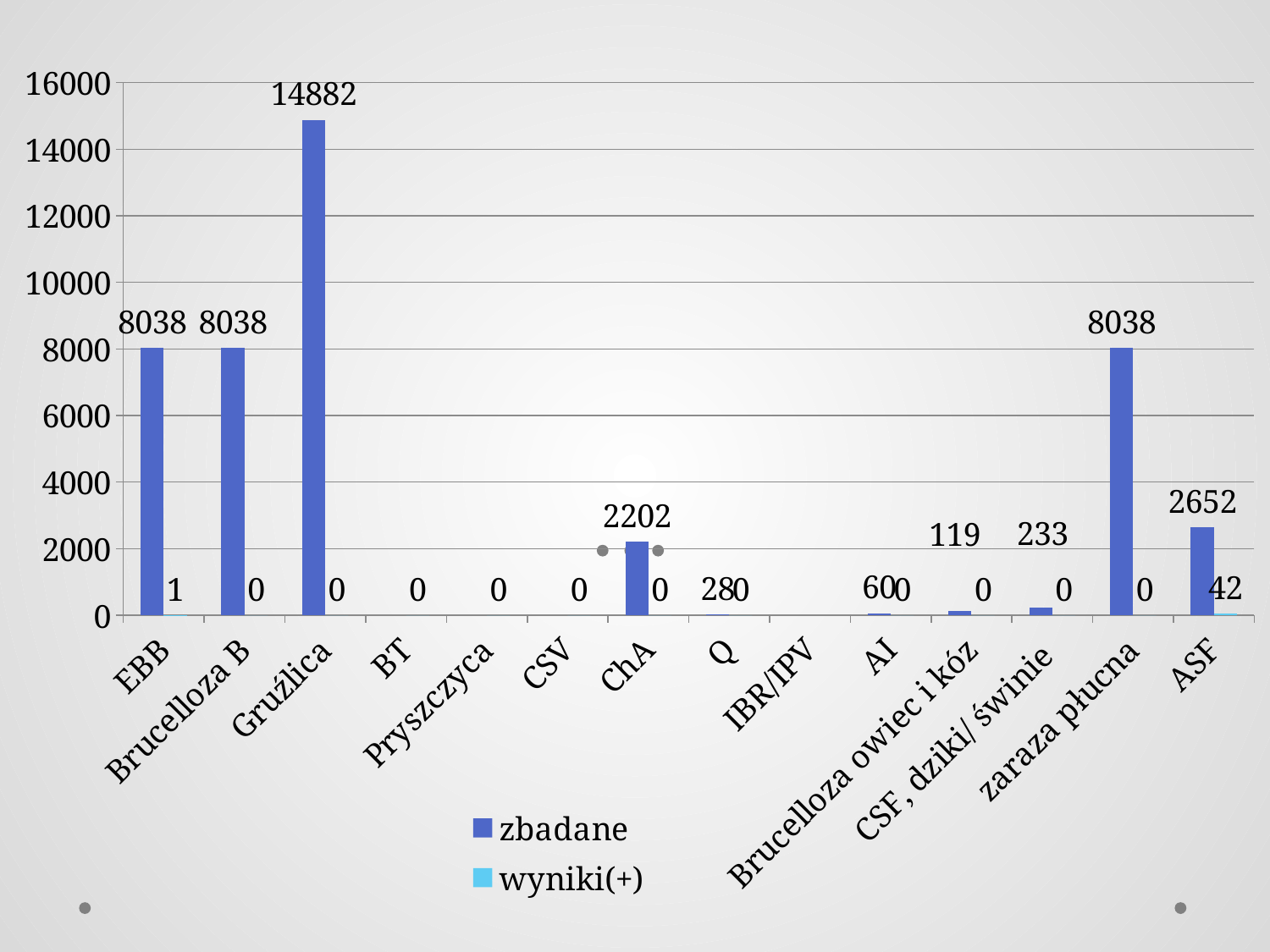
What is the wyniki(+) value for ASF? 42 What is the zbadane value for CSF, dziki/ świnie? 233 What is the wyniki(+) value for EBB? 1 What kind of chart is shown on the slide? bar chart What is the zbadane value for Gruźlica? 14882 How many series does the legend list? 2 Which category has the highest zbadane value? Gruźlica Which has a larger zbadane value, ASF or ChA? ASF What is the zbadane value for Bruceloza owiec i kóz? 119 How many categories are shown on the x axis? 14 What is the difference between the zbadane values for Gruźlica and EBB? 6844 Is the zbadane value for zaraza płucna greater or less than 6000? greater